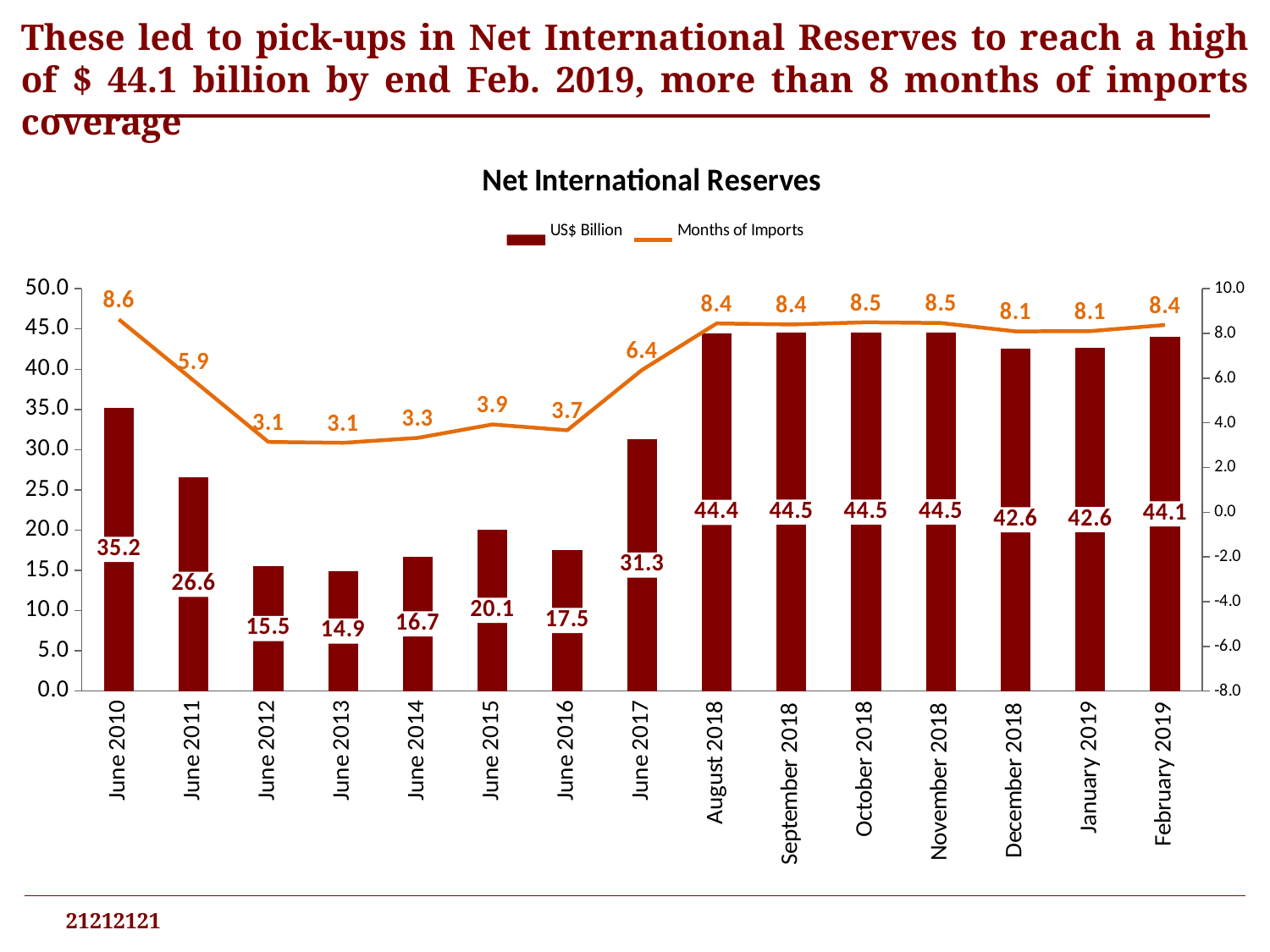
Which period has the highest Months of Imports value? June 2010 What is the difference in US$ Billion between February 2019 and December 2018? 1.5 What is the US$ Billion value for June 2010? 35.2 What is the Months of Imports value for June 2017? 6.4 Which period has the lowest US$ Billion value? June 2013 Which has the larger US$ Billion value, June 2011 or June 2015? June 2011 What is the difference in Months of Imports between June 2010 and June 2011? 2.7 How many periods are shown on the x axis? 15 What is the Months of Imports value for December 2018? 8.1 What kind of chart is this? Combination bar and line chart How many series does the legend list? 2 Do the US$ Billion values rise or fall from June 2010 to June 2013? Fall